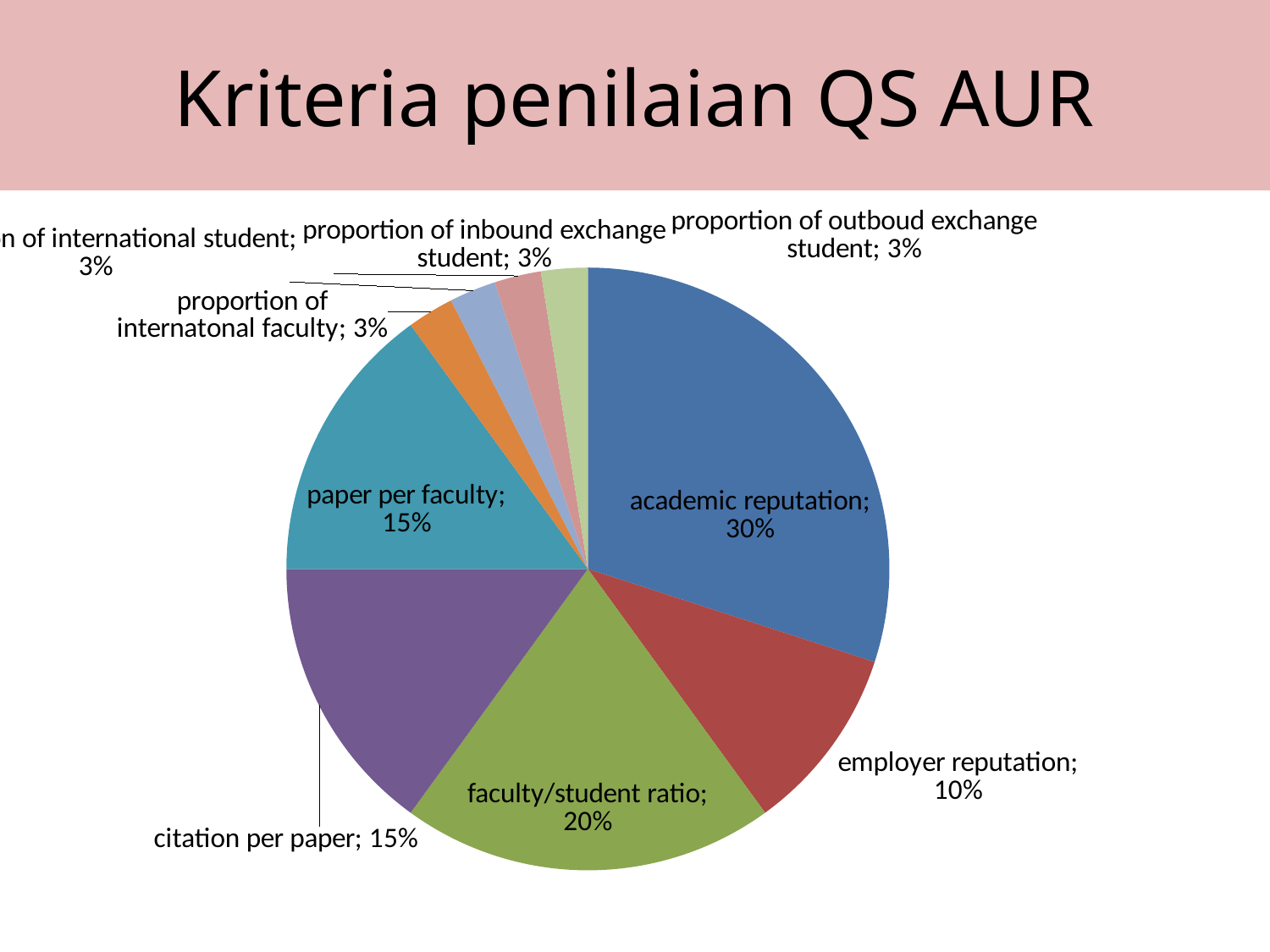
What is the title of the slide containing the pie chart? Kriteria penilaian QS AUR What is the smallest percentage shown on any slice of the pie? 3% What type of chart is shown on the slide? pie chart Which is larger, the share for paper per faculty or the share for employer reputation? paper per faculty Which category has the largest slice of the pie? academic reputation What share of the pie does employer reputation have? 10% How many slices does the pie chart have? 9 What share of the pie does faculty/student ratio have? 20% What is the difference between the shares of academic reputation and faculty/student ratio? 10% What share of the pie does proportion of inbound exchange student have? 3% What share of the pie does citation per paper have? 15% What share of the pie does academic reputation have? 30%